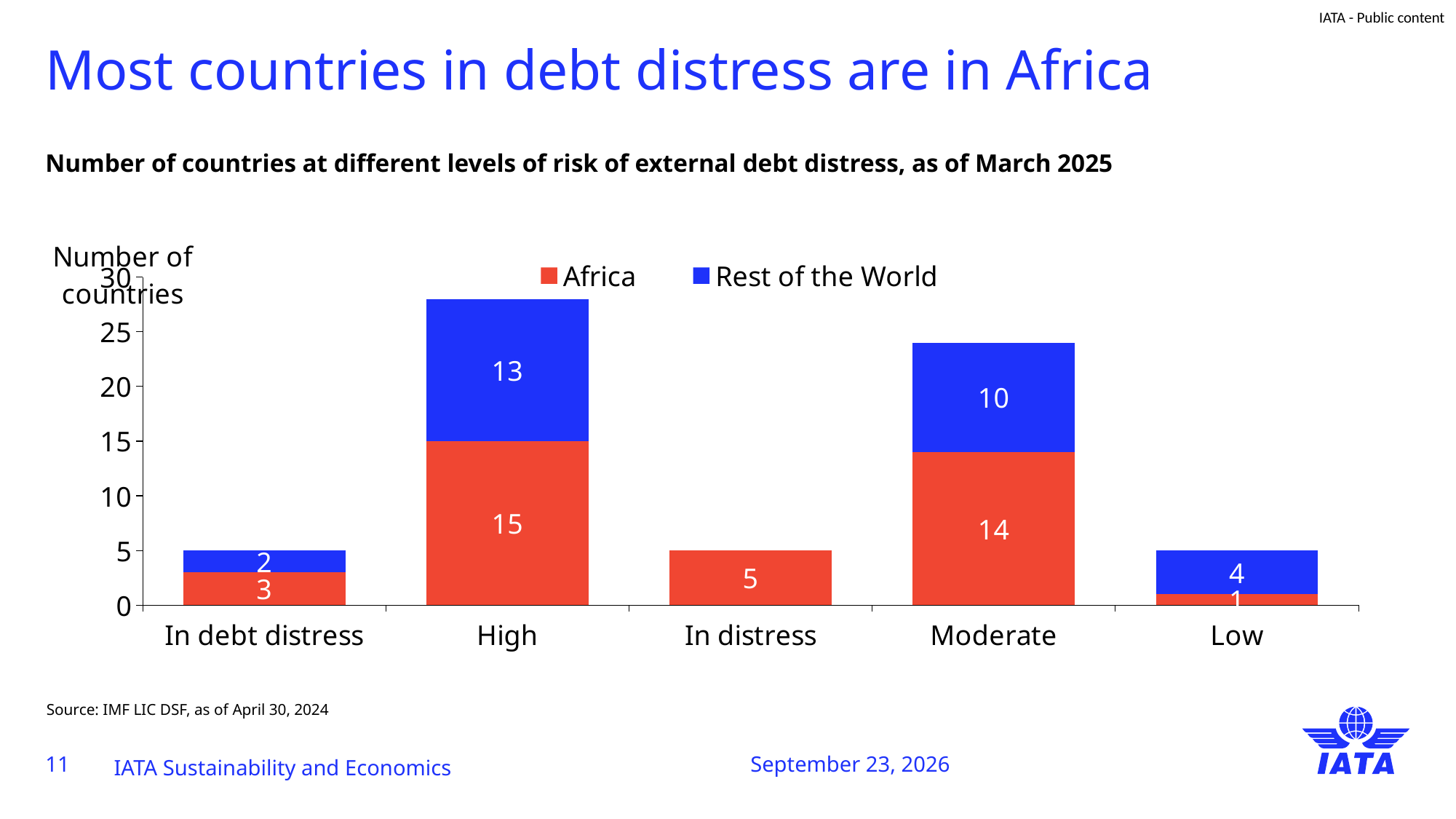
What is the value for Africa in the Low category? 1 How many categories are shown on the x axis? 5 What kind of chart is shown on the slide? Stacked bar chart Which is larger in the Low category, Africa or Rest of the World? Rest of the World What is the total of the stacked bar for the High category? 28 How many series does the legend list? 2 Which category has the highest value for Africa? High Which category has the lowest value for Africa? Low What is the total of the stacked bar for the Moderate category? 24 What is the value for Africa in the High category? 15 What is the difference between the Africa and Rest of the World values in the High category? 2 What is the value for Rest of the World in the Moderate category? 10